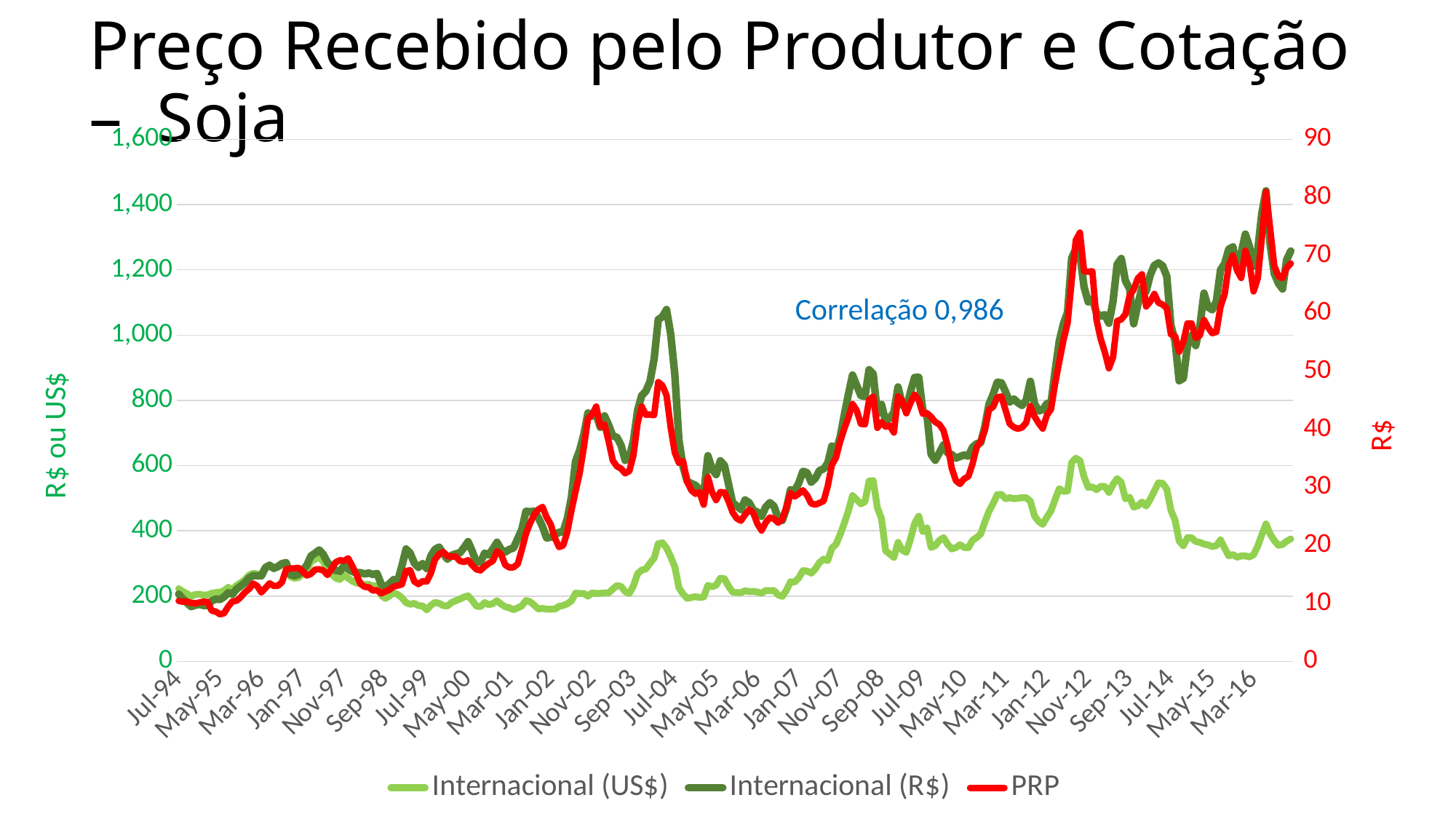
Does the PRP series generally rise or fall from Jul-94 to Mar-16? rise Is the value of Internacional (R$) at Mar-16 greater or less than 1,000 on the left axis? greater Does the Internacional (R$) series generally rise or fall from Jul-94 to Mar-16? rise Is the value of PRP at Jul-94 greater or less than 20 on the right axis? less Is the value of Internacional (US$) at Mar-16 greater or less than 600 on the left axis? less What are the three series named in the legend? Internacional (US$), Internacional (R$), PRP At Mar-16, which is higher on the left axis: Internacional (R$) or Internacional (US$)? Internacional (R$) Which of the two Internacional series reaches the higher values on the left axis? Internacional (R$) What correlation value is annotated on the chart? 0,986 What kind of chart is shown on the slide? line chart How many series does the legend list? 3